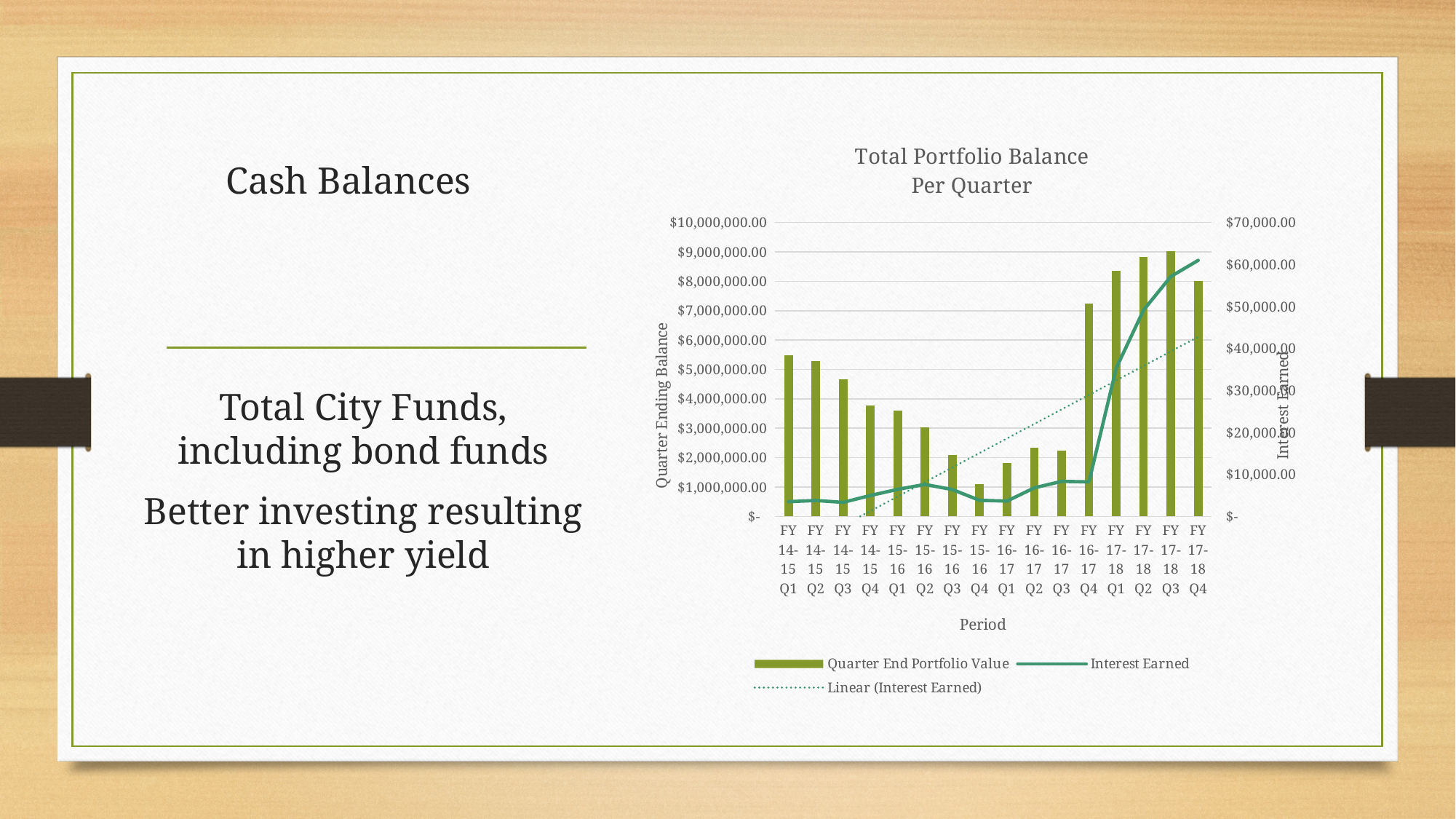
Which period has the highest Quarter End Portfolio Value bar? FY 17-18 Q3 Which has the larger Quarter End Portfolio Value, FY 14-15 Q1 or FY 15-16 Q1? FY 14-15 Q1 Is the Interest Earned for FY 14-15 Q1 greater or less than $10,000.00? less Is the Quarter End Portfolio Value for FY 14-15 Q4 greater or less than $4,000,000.00? less Is the Quarter End Portfolio Value for FY 17-18 Q1 greater or less than $8,000,000.00? greater What is the title of the chart? Total Portfolio Balance Per Quarter Which period has the lowest Quarter End Portfolio Value bar? FY 15-16 Q4 What kind of chart is shown on the slide? Combination bar and line chart Do the Quarter End Portfolio Value bars rise or fall from FY 14-15 Q1 to FY 15-16 Q4? fall How many periods (quarters) are shown on the x axis? 16 How many series does the chart legend list? 3